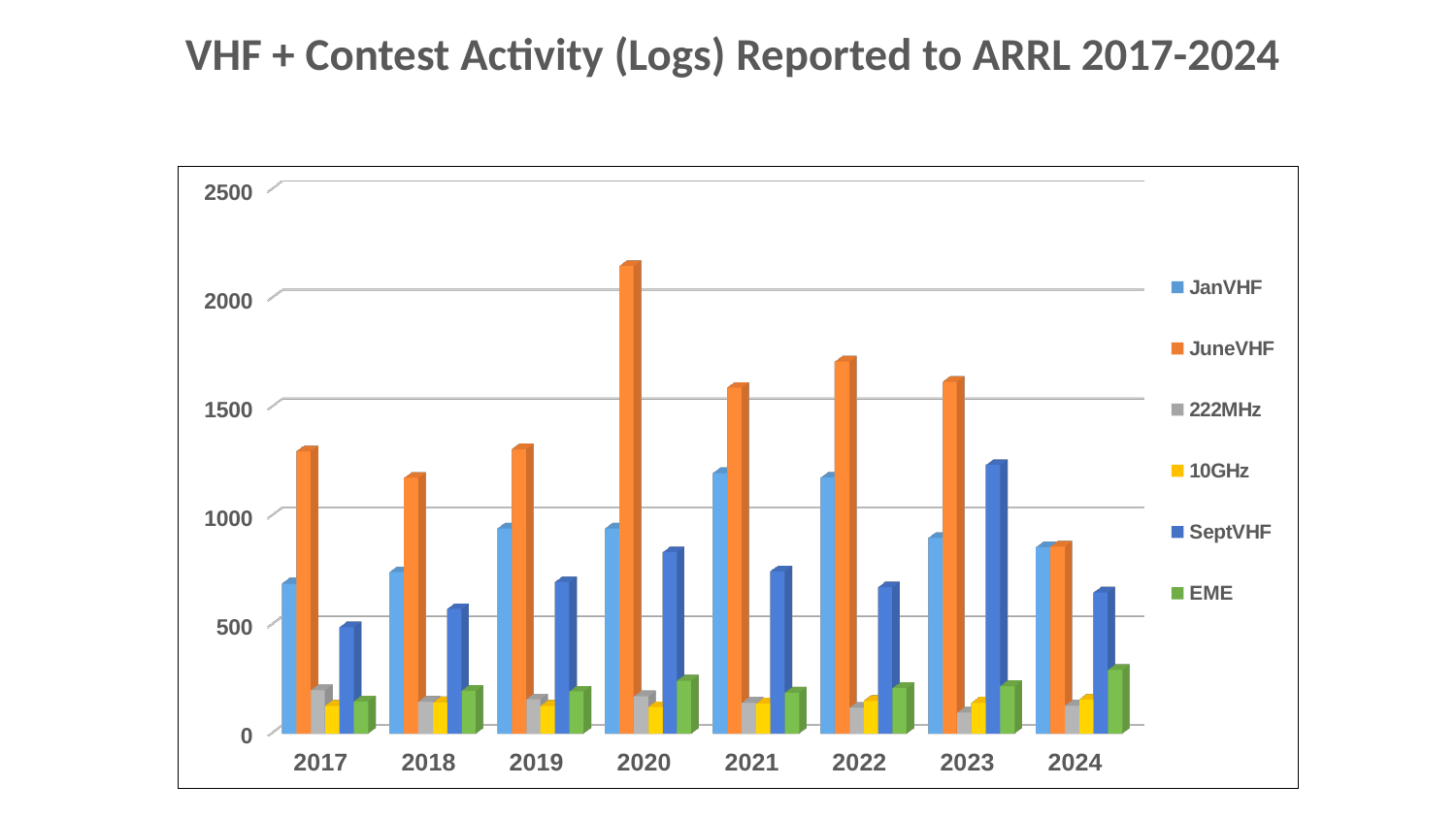
Is the SeptVHF value for 2023 greater or less than 1000? greater How many years are shown on the x axis? 8 What kind of chart is shown on the slide? bar chart How many series does the legend list? 6 In 2023, which is larger: JanVHF or SeptVHF? SeptVHF Is the JuneVHF value for 2020 greater or less than 2000? greater What colour represents the JuneVHF series in the legend? orange Does the SeptVHF value rise or fall from 2017 to 2020? rise In which year is the SeptVHF value highest? 2023 In which year is the JuneVHF value lowest? 2024 Is the JanVHF value for 2021 greater or less than 1000? greater In which year is the JuneVHF value highest? 2020